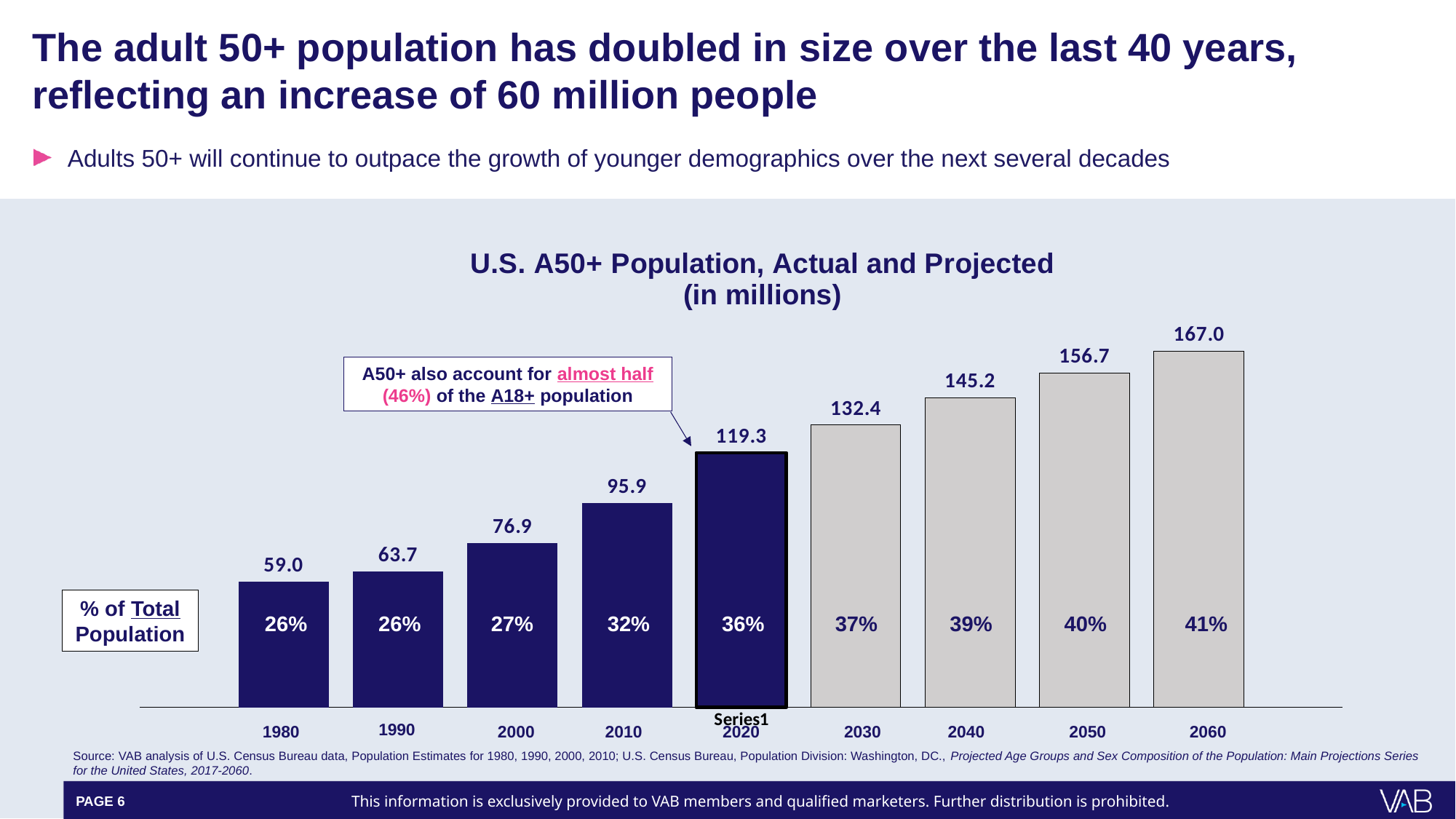
What is the U.S. A50+ population value shown for 2020? 119.3 What is the difference between the A50+ population values for 2030 and 2020? 13.1 Which year has the lowest A50+ population value on the chart? 1980 How many years (bars) are shown on the chart? 9 Do the A50+ population values rise or fall from 1980 to 2060? Rise What is the difference between the A50+ population values for 2060 and 1980? 108.0 What is the title of the chart? U.S. A50+ Population, Actual and Projected (in millions) Which is larger, the A50+ population value for 2000 or for 2010? 2010 Which year has the highest A50+ population value on the chart? 2060 What is the projected A50+ population value for 2060? 167.0 What percentage of the total population did adults 50+ account for in 2010? 32% What kind of chart is used to show the U.S. A50+ population? Bar chart